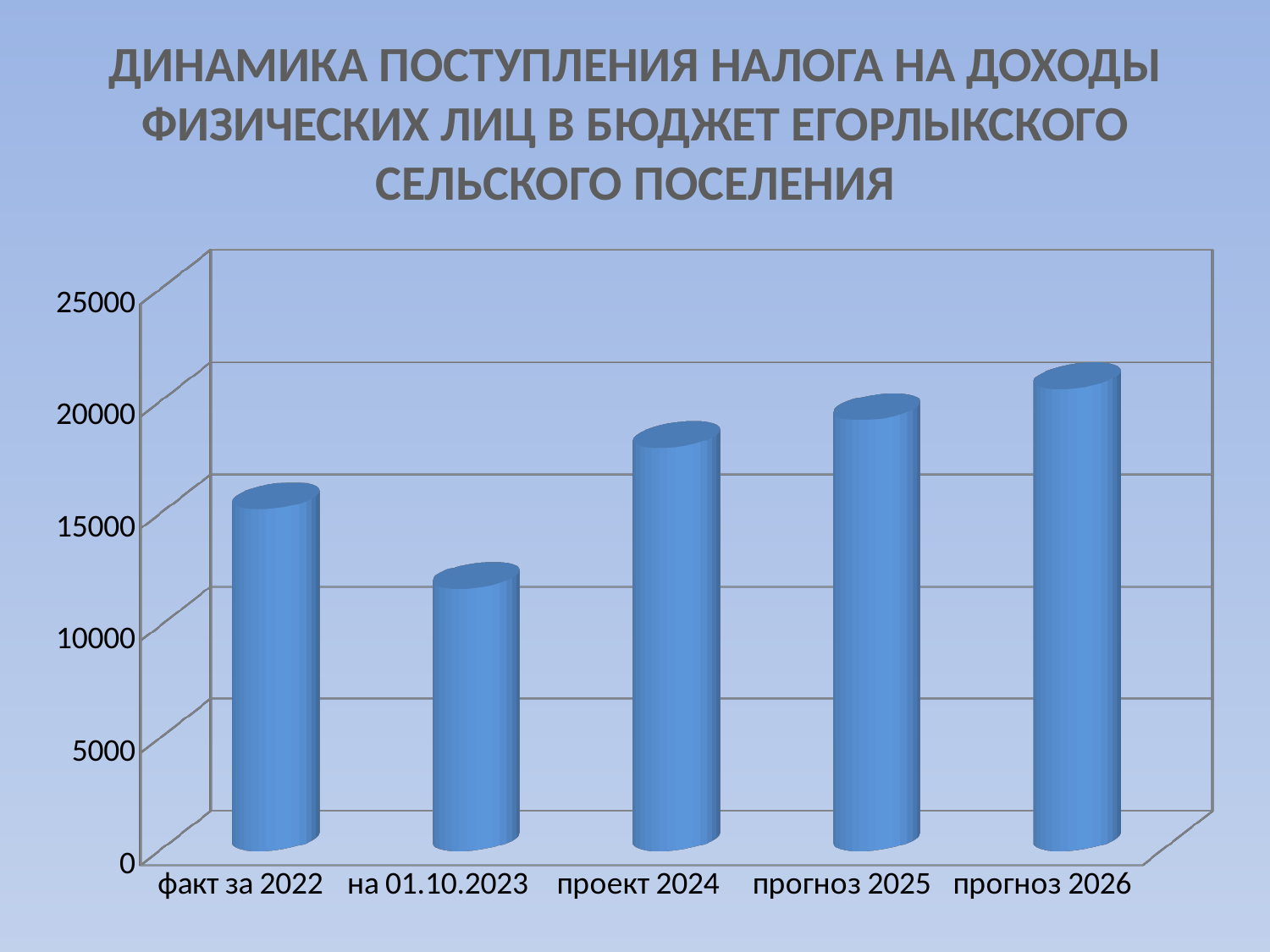
What kind of chart is shown on the slide? bar chart Is the value for на 01.10.2023 greater or less than 15000? less From проект 2024 to прогноз 2026, do the values rise or fall? rise Which is larger: the value for факт за 2022 or the value for прогноз 2026? прогноз 2026 What is the title of the chart on the slide? ДИНАМИКА ПОСТУПЛЕНИЯ НАЛОГА НА ДОХОДЫ ФИЗИЧЕСКИХ ЛИЦ В БЮДЖЕТ ЕГОРЛЫКСКОГО СЕЛЬСКОГО ПОСЕЛЕНИЯ Is the value for проект 2024 greater or less than 15000? greater How many categories are shown on the x axis of the chart? 5 Is the value for на 01.10.2023 greater or less than 10000? greater Which is larger: the value for проект 2024 or the value for на 01.10.2023? проект 2024 Which category has the highest value in the chart? прогноз 2026 Which category has the lowest value in the chart? на 01.10.2023